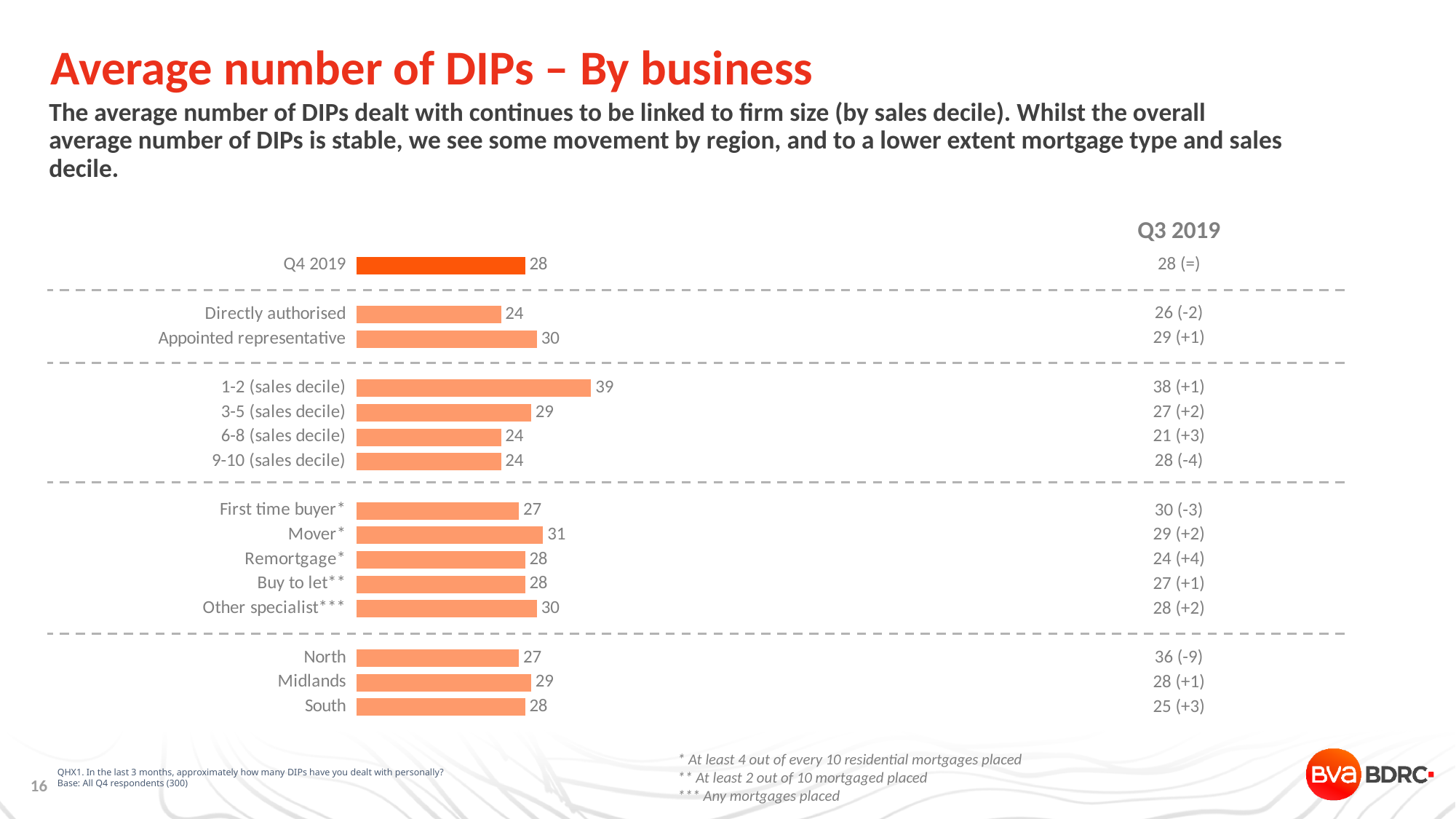
What is the value for North? 27 What is the average number of DIPs for Q4 2019 overall? 28 Which category has the highest value on the chart? 1-2 (sales decile) What is the difference between the values for 1-2 (sales decile) and 9-10 (sales decile)? 15 How many region categories (North, Midlands, South) are shown in the bottom group of the chart? 3 Which is larger, the value for Mover or the value for First time buyer? Mover What kind of chart is shown on the slide? Bar chart Which is larger, the value for Midlands or the value for North? Midlands What is the value for 1-2 (sales decile)? 39 What is the difference between the values for Appointed representative and Directly authorised? 6 What is the value for Appointed representative? 30 What is the value for Mover? 31